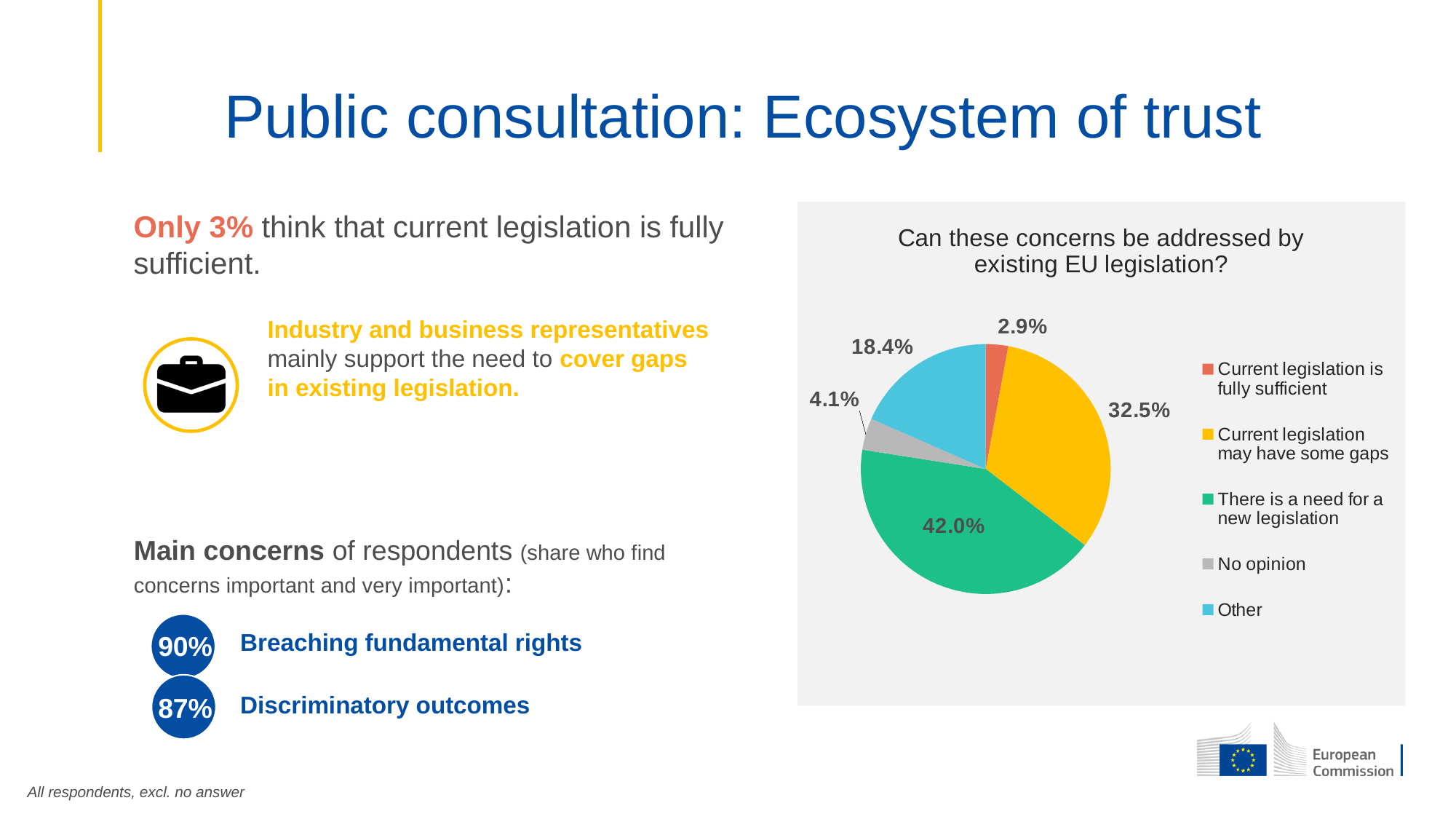
Which is larger: the share for 'Other' or the share for 'No opinion'? Other Which category has the largest share of the pie? There is a need for a new legislation What share of respondents say current legislation is fully sufficient? 2.9% What share of respondents say current legislation may have some gaps? 32.5% How many categories does the legend list? 5 What is the difference between the share for 'There is a need for a new legislation' and 'Current legislation may have some gaps'? 9.5% What share of respondents have no opinion? 4.1% Which category has the smallest share of the pie? Current legislation is fully sufficient What share of respondents say there is a need for a new legislation? 42.0% What share of respondents answered 'Other'? 18.4% What is the title of the chart? Can these concerns be addressed by existing EU legislation? What kind of chart is shown on the slide? Pie chart